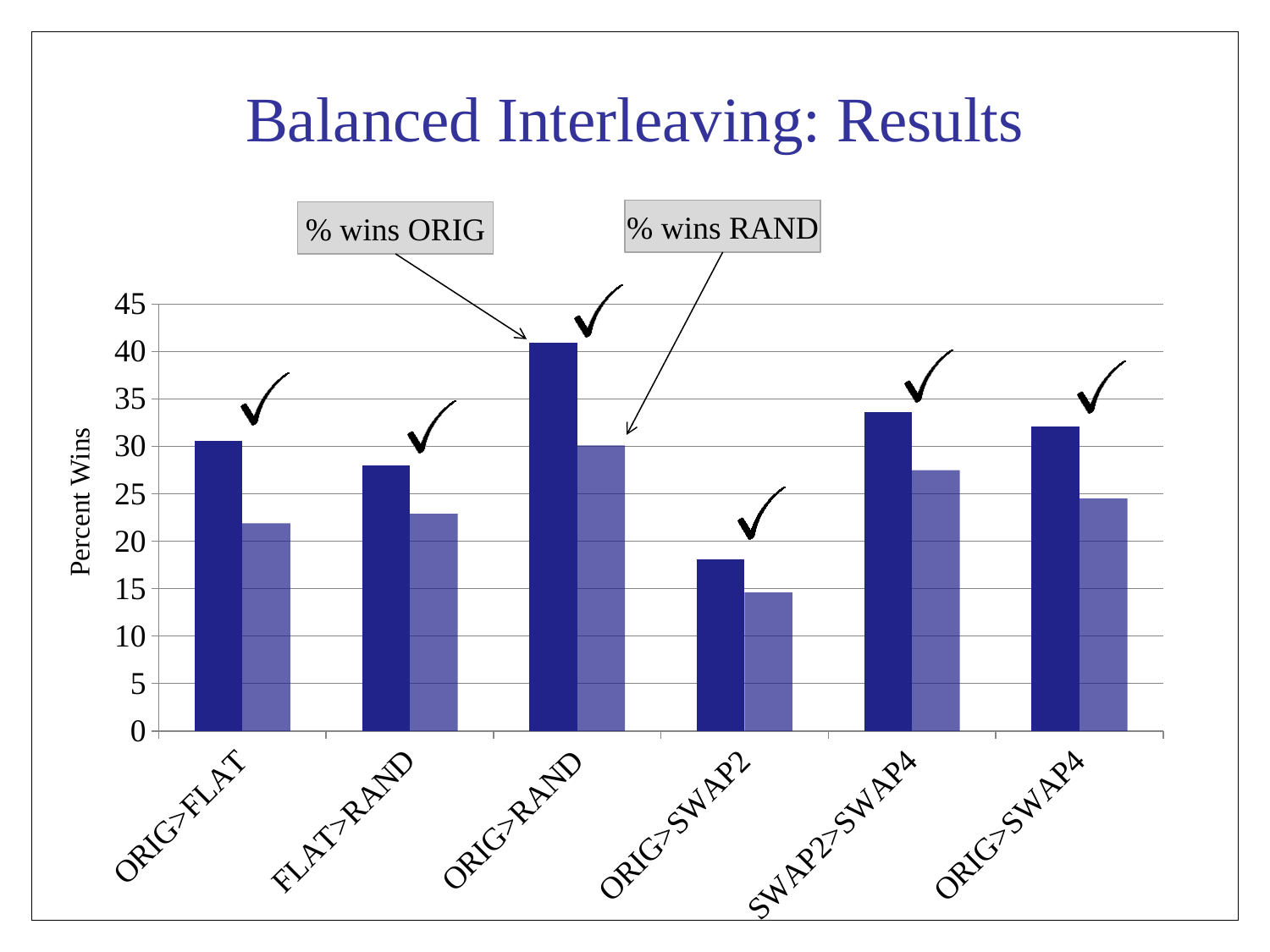
Is the light blue bar for SWAP2>SWAP4 greater or less than 25? greater Which category has the shortest dark blue bar? ORIG>SWAP2 Which category has the tallest dark blue bar? ORIG>RAND Is the dark blue bar for ORIG>SWAP2 greater or less than 20? less Which is taller, the dark blue bar for ORIG>FLAT or the dark blue bar for FLAT>RAND? ORIG>FLAT What is the label on the vertical axis of the chart? Percent Wins In the ORIG>SWAP4 category, which bar is taller, the dark blue bar or the light blue bar? the dark blue bar How many categories are shown along the x axis of the chart? 6 Which category has the shortest light blue bar? ORIG>SWAP2 What kind of chart is shown on the slide? bar chart How many bars are plotted for each category in the chart? 2 Is the dark blue bar for ORIG>RAND greater or less than 35? greater